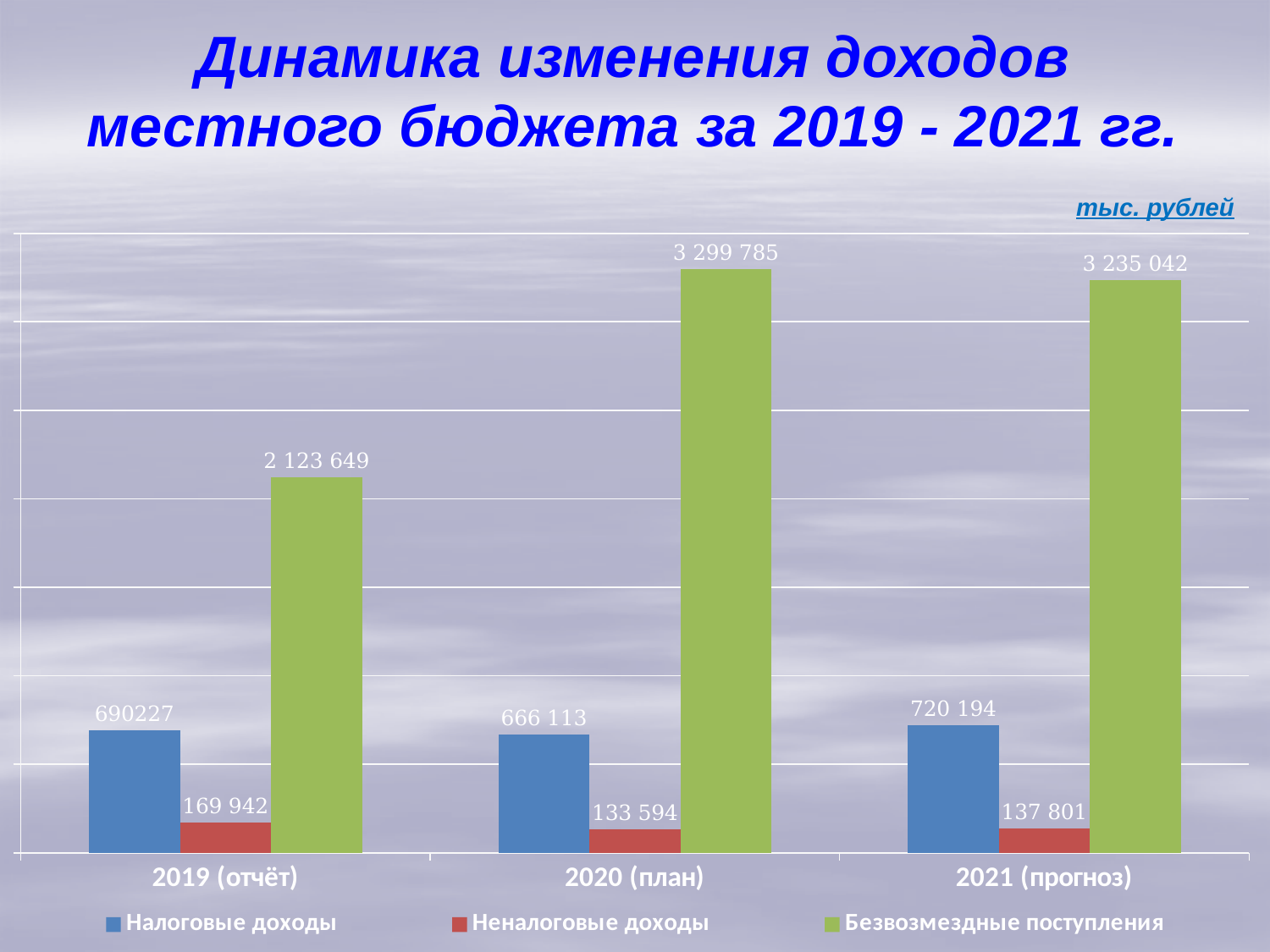
What type of chart is shown on the slide? Bar chart In which year is Безвозмездные поступления the highest? 2020 (план) What is the difference between Налоговые доходы in 2021 (прогноз) and 2020 (план)? 54 081 In which year is Неналоговые доходы the lowest? 2020 (план) Which is larger: Налоговые доходы in 2019 (отчёт) or in 2020 (план)? 2019 (отчёт) What is the value of Неналоговые доходы for 2021 (прогноз)? 137 801 How many year categories are shown on the x axis? 3 How many series does the legend list? 3 What is the value of Налоговые доходы for 2019 (отчёт)? 690227 What is the value of Безвозмездные поступления for 2021 (прогноз)? 3 235 042 What is the difference between Безвозмездные поступления in 2020 (план) and 2021 (прогноз)? 64 743 What is the value of Безвозмездные поступления for 2020 (план)? 3 299 785